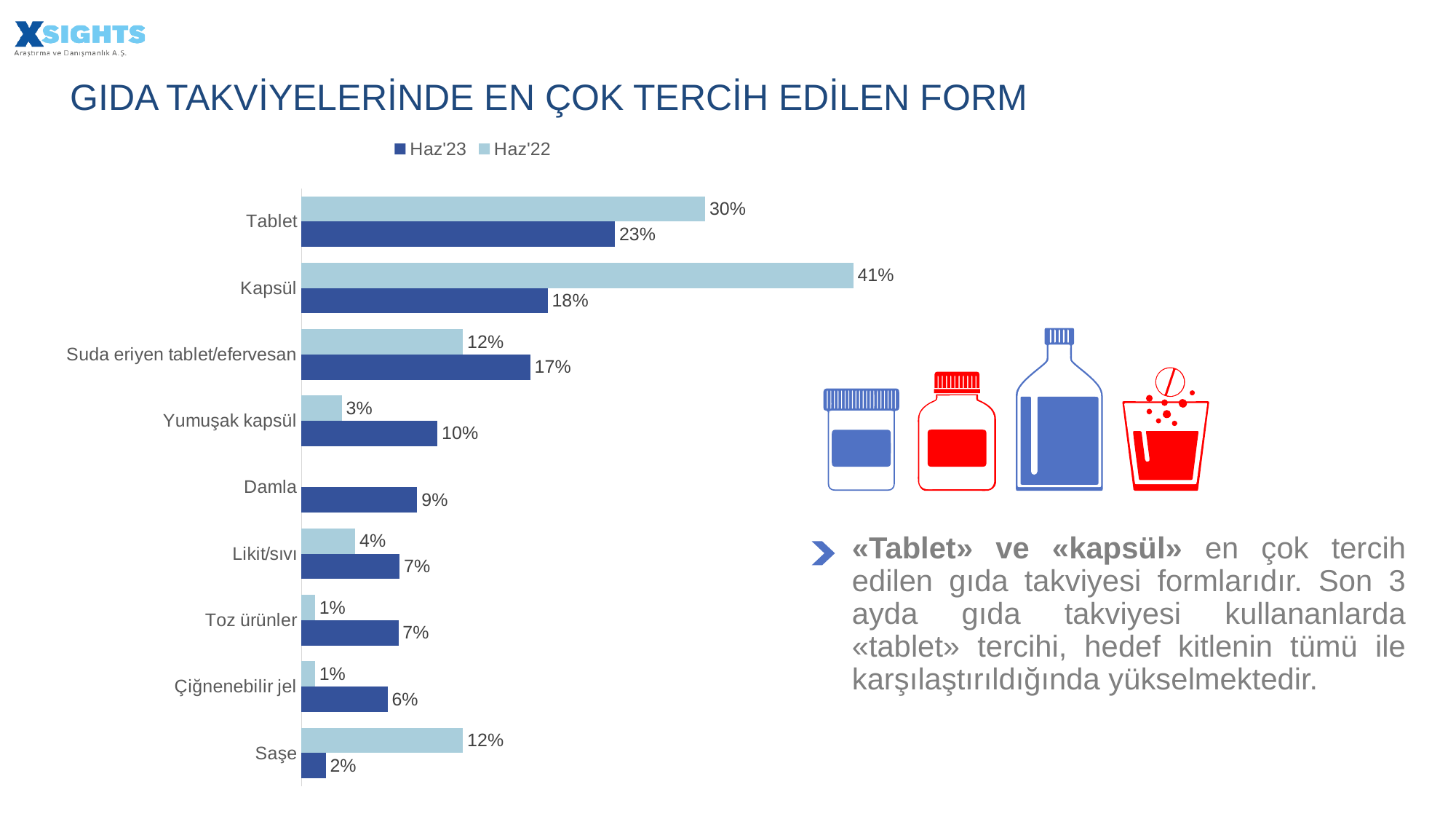
What is the Haz'22 value for Kapsül? 41% Which category has the lowest Haz'23 value? Saşe What is the difference between the Haz'22 and Haz'23 values for Saşe? 10% What is the Haz'23 value for Suda eriyen tablet/efervesan? 17% What is the title of the chart on the slide? GIDA TAKVİYELERİNDE EN ÇOK TERCİH EDİLEN FORM Which is larger for Yumuşak kapsül, the Haz'23 value or the Haz'22 value? Haz'23 What is the Haz'23 value for Tablet? 23% What kind of chart is shown on the slide? bar chart How many categories are shown on the chart? 9 How many series does the legend list? 2 What is the difference between the Haz'22 and Haz'23 values for Kapsül? 23% Which category has the highest Haz'23 value? Tablet